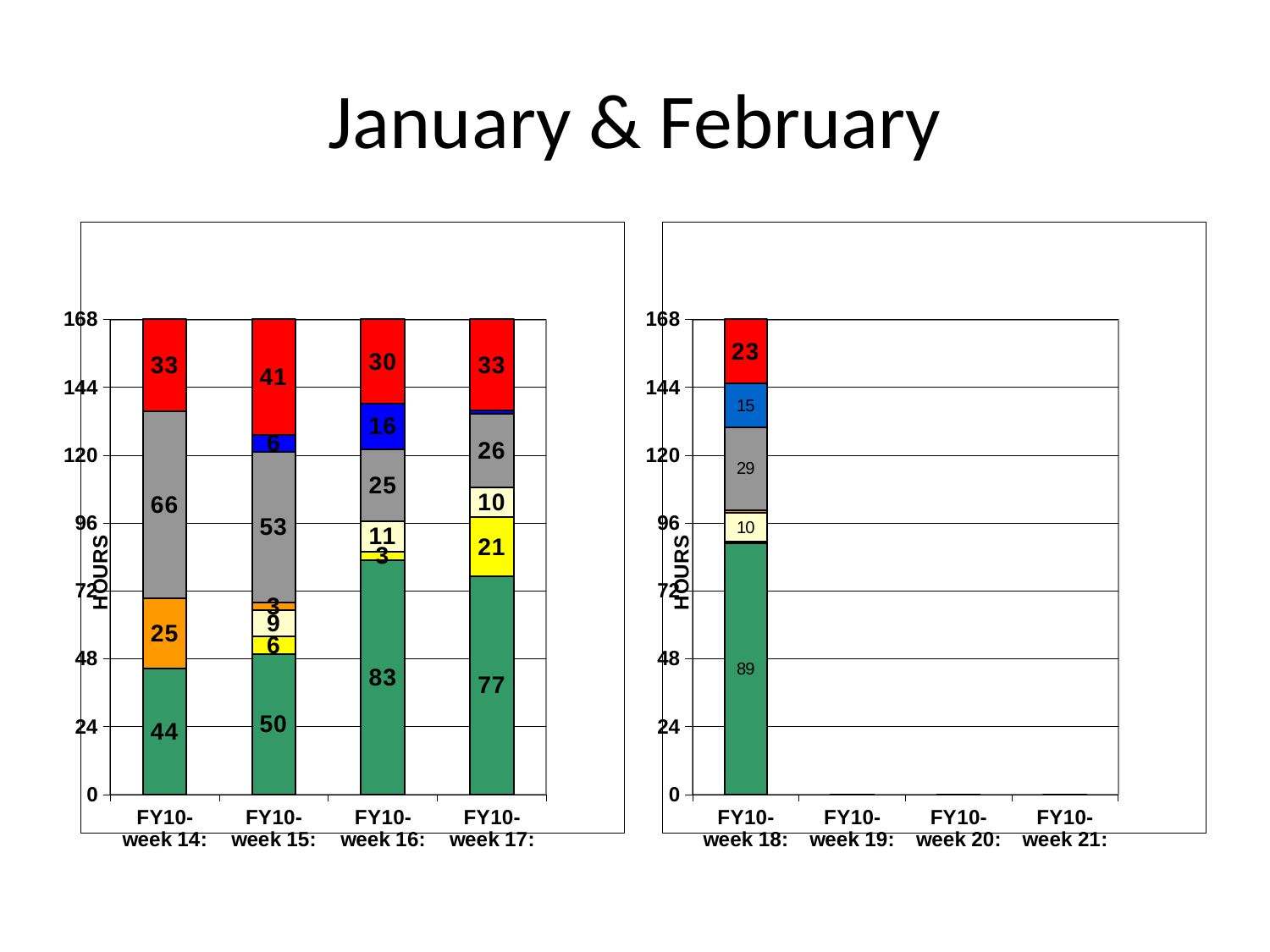
In the left chart, is the red segment larger for FY10-week 15 or FY10-week 16? FY10-week 15 How many week categories are shown on the x axis of the right chart? 4 In the left chart, what is the value of the gray segment for FY10-week 16? 25 In the left chart, which week has the smallest green segment? FY10-week 14 In the right chart, what is the value of the green segment for FY10-week 18? 89 What type of chart is shown on the left of the slide? Stacked bar chart In the left chart, what is the difference between the gray segment for FY10-week 14 and the gray segment for FY10-week 15? 13 In the right chart, what is the value of the blue segment for FY10-week 18? 15 In the left chart, what is the value of the green segment for FY10-week 14? 44 In the left chart, what is the value of the red segment for FY10-week 15? 41 In the left chart, what is the total of the stacked bar for FY10-week 14? 168 In the left chart, which week has the largest green segment? FY10-week 16